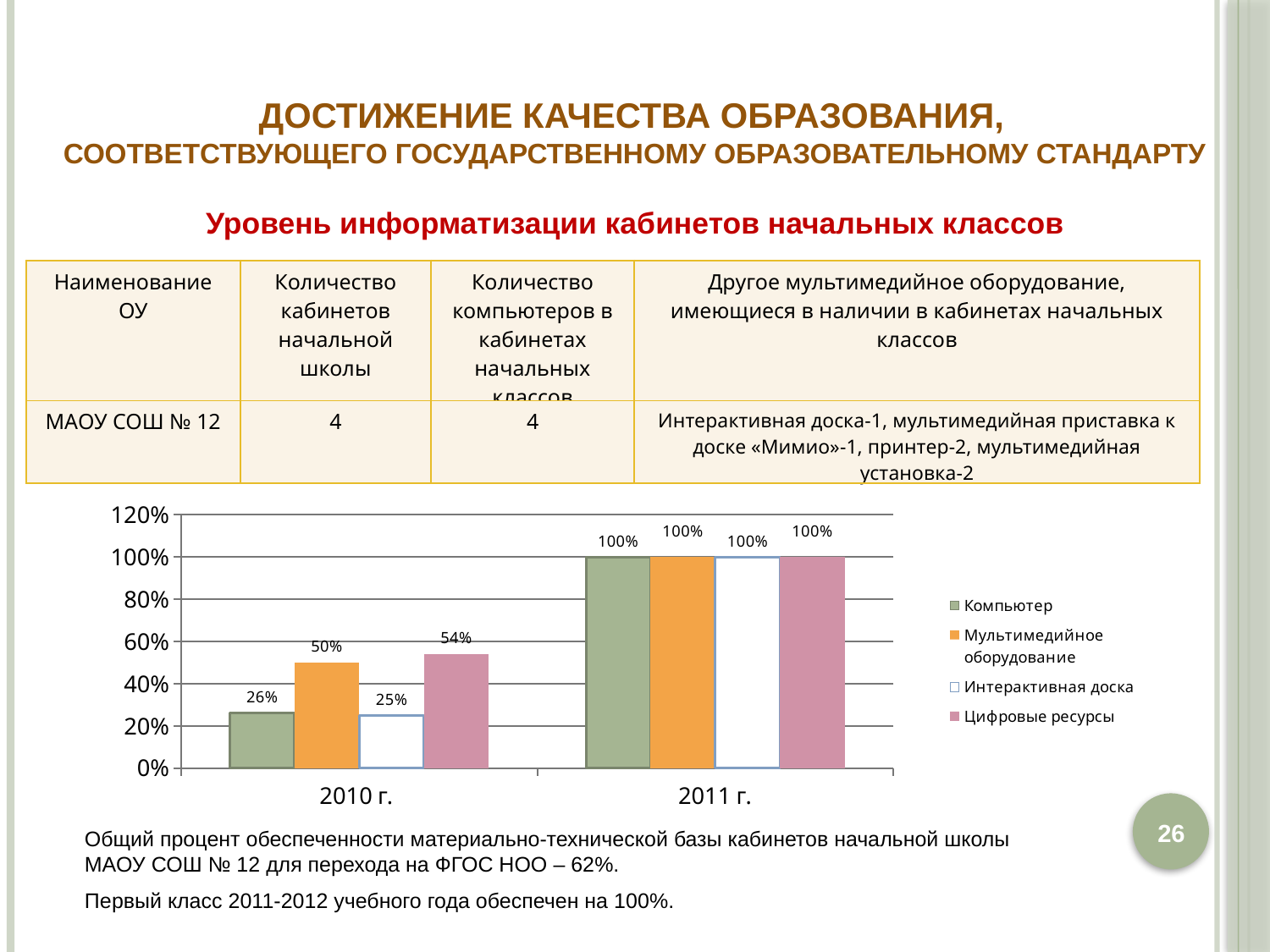
How many series does the legend list? 4 What is the value for Цифровые ресурсы in 2010 г.? 54% Which series has the lowest value in 2010 г.? Интерактивная доска What is the value for Компьютер in 2011 г.? 100% Which series has the highest value in 2010 г.? Цифровые ресурсы What is the difference between the Мультимедийное оборудование value in 2011 г. and in 2010 г.? 50% What kind of chart is shown on the slide? Bar chart Do the values for Цифровые ресурсы rise or fall from 2010 г. to 2011 г.? Rise Which is larger in 2010 г.: Компьютер or Мультимедийное оборудование? Мультимедийное оборудование What is the value for Мультимедийное оборудование in 2010 г.? 50% What is the value for Компьютер in 2010 г.? 26% What is the value for Интерактивная доска in 2010 г.? 25%